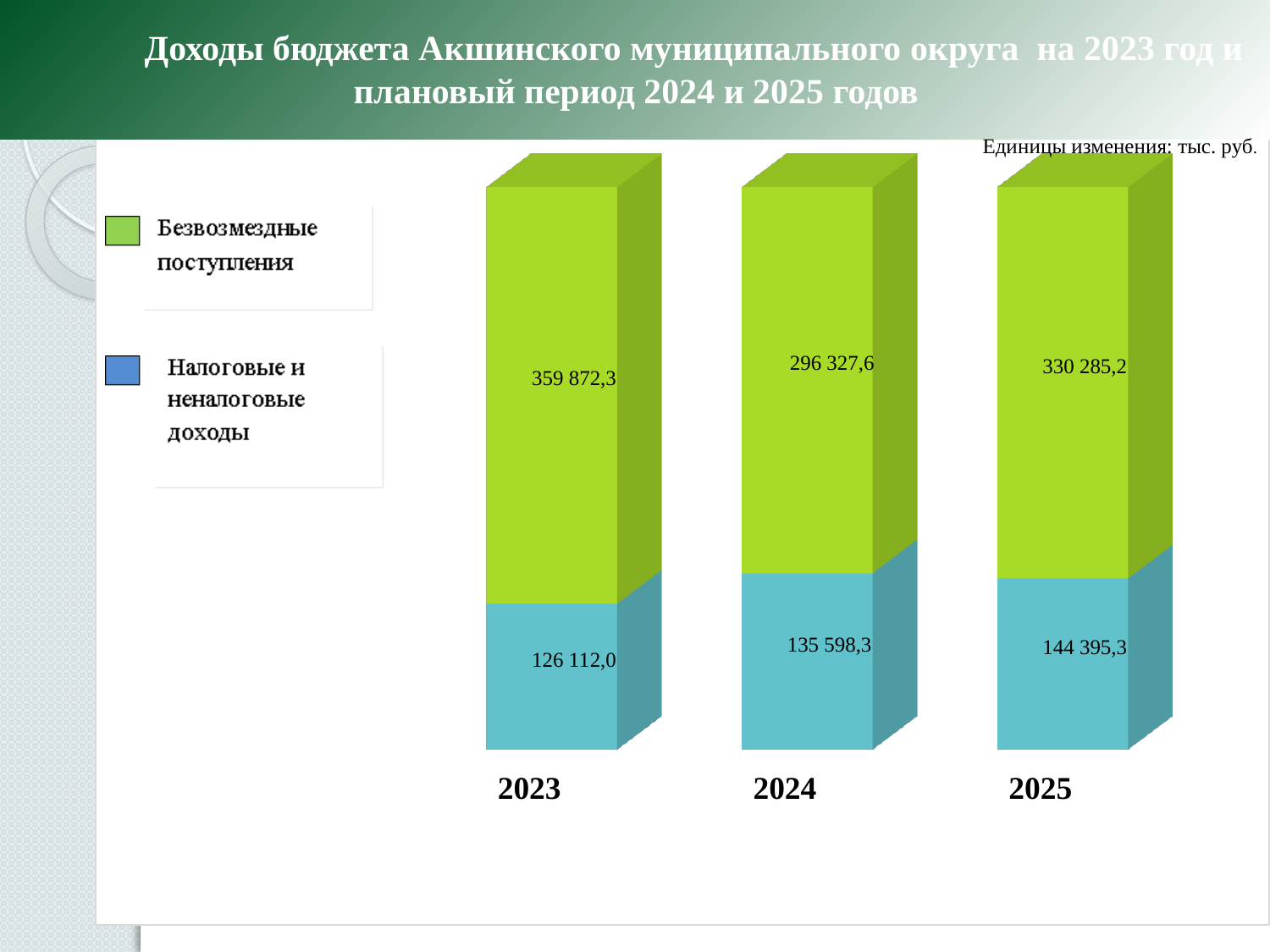
In which year is Безвозмездные поступления the lowest? 2024 What is the value of Налоговые и неналоговые доходы for 2025? 144 395,3 Which is larger: Налоговые и неналоговые доходы in 2023 or in 2025? 2025 How many years (categories) are shown on the chart? 3 What is the total of the stacked bar for 2024? 431 925,9 In which year is Налоговые и неналоговые доходы the highest? 2025 What is the value of Безвозмездные поступления for 2023? 359 872,3 How many series does the legend list? 2 What type of chart is shown on the slide? Stacked bar chart What is the difference between Безвозмездные поступления in 2023 and in 2024? 63 544,7 What is the value of Налоговые и неналоговые доходы for 2024? 135 598,3 What is the total of the stacked bar for 2023? 485 984,3